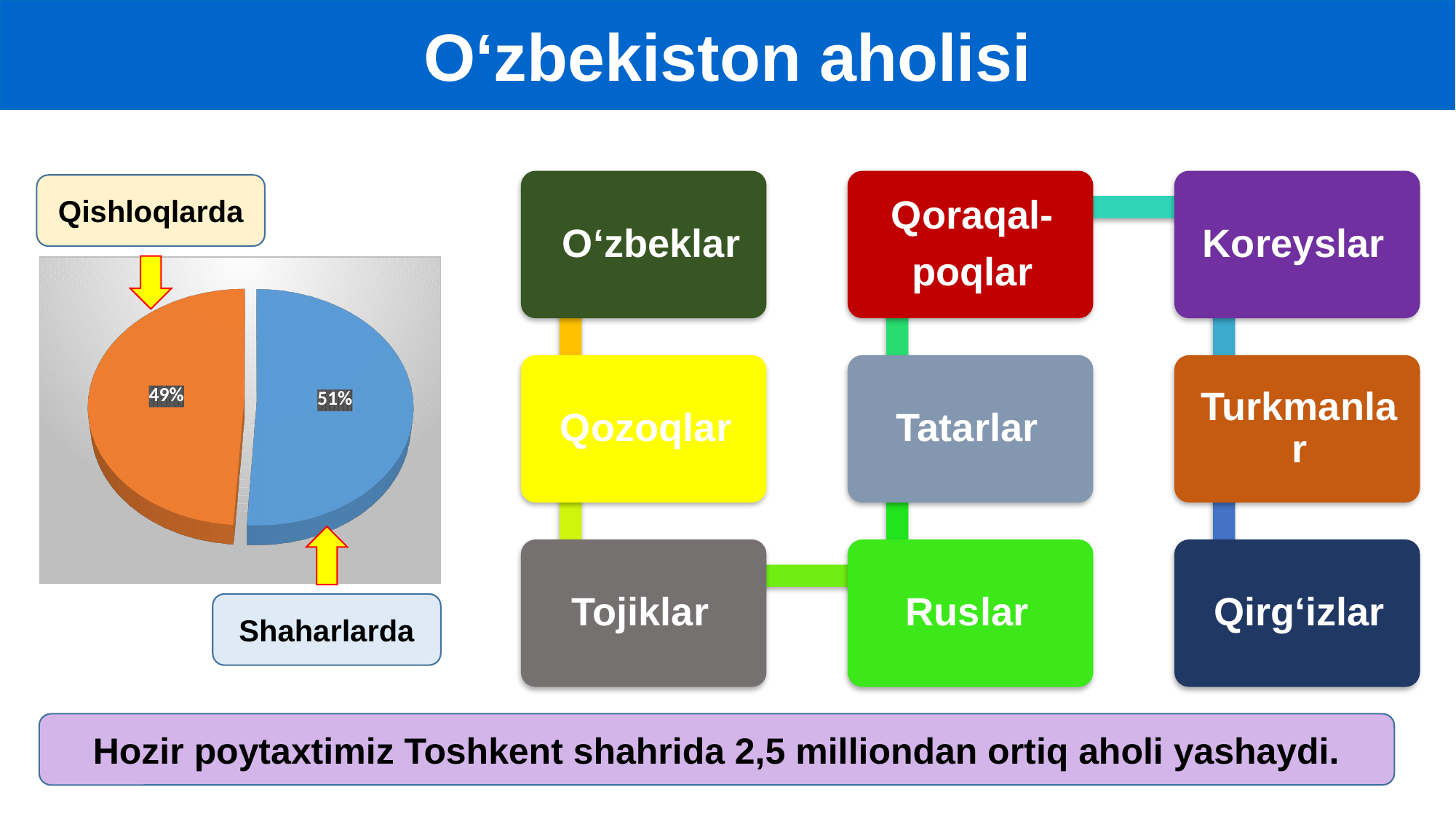
What share of the pie does the Shaharlarda slice represent? 51% Which is larger in the pie chart, Qishloqlarda or Shaharlarda? Shaharlarda What share of the pie does the Qishloqlarda slice represent? 49% Which slice of the pie chart is the largest? Shaharlarda What colour is the Qishloqlarda slice of the pie chart? orange Is the value for Qishloqlarda greater or less than 50%? less How many slices does the pie chart have? 2 What is the difference in percentage points between the Shaharlarda and Qishloqlarda slices? 2 What kind of chart is shown on the left of the slide? pie chart Is the value for Shaharlarda greater or less than 50%? greater Which slice of the pie chart is the smallest? Qishloqlarda What colour is the Shaharlarda slice of the pie chart? blue